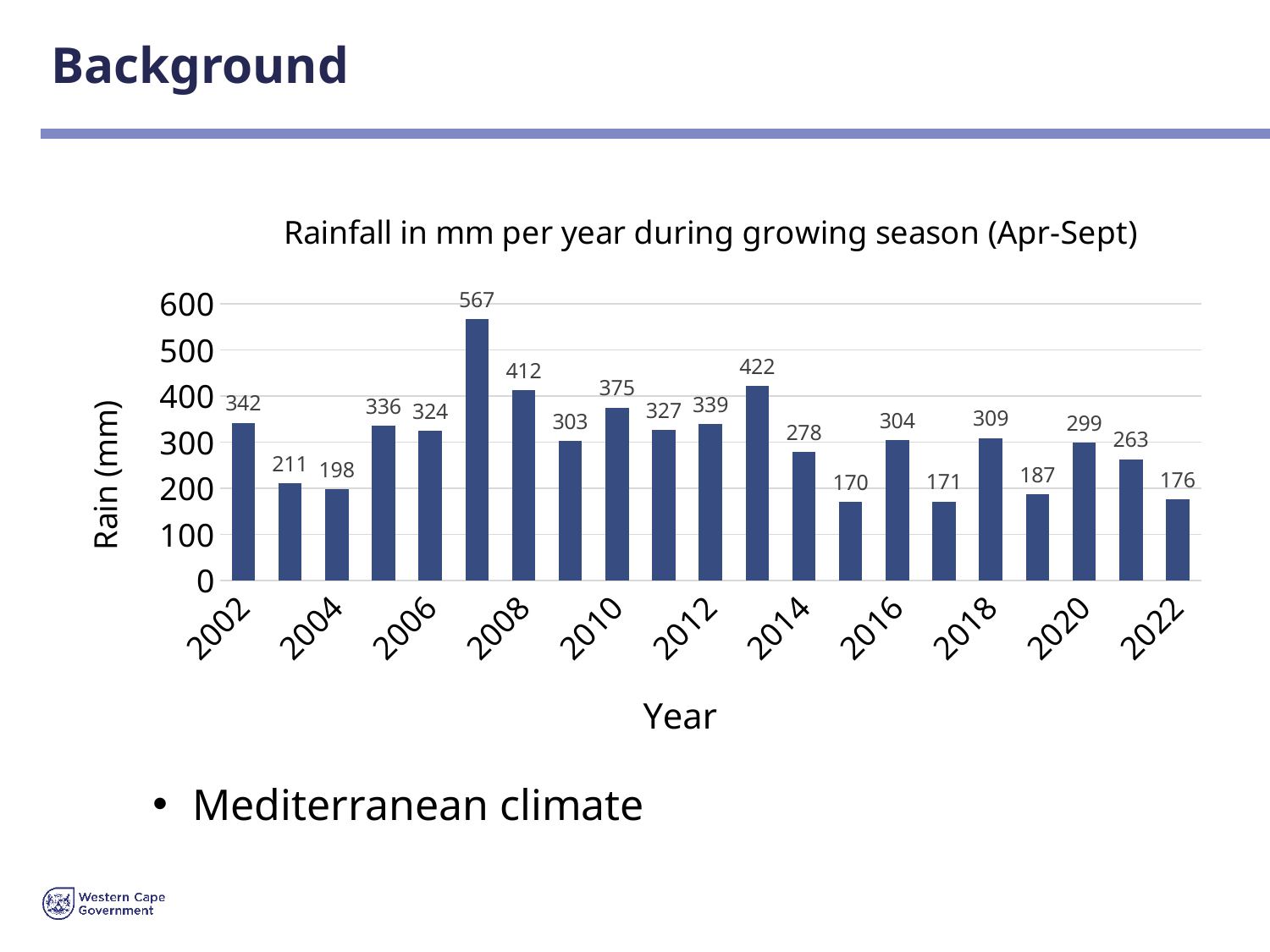
What is the difference in rainfall between 2010 and 2020? 76 Which year had more rainfall, 2006 or 2016? 2006 What was the rainfall in mm in 2008? 412 What is the title of the chart? Rainfall in mm per year during growing season (Apr-Sept) What is the highest rainfall value shown on the chart? 567 What kind of chart is shown on the slide? Bar chart What was the rainfall in mm in 2014? 278 Is the rainfall value for 2012 greater or less than 300? greater How many bars (years) are plotted on the chart? 21 What is the lowest rainfall value shown on the chart? 170 What was the rainfall in mm in 2002? 342 What was the rainfall in mm in 2022? 176